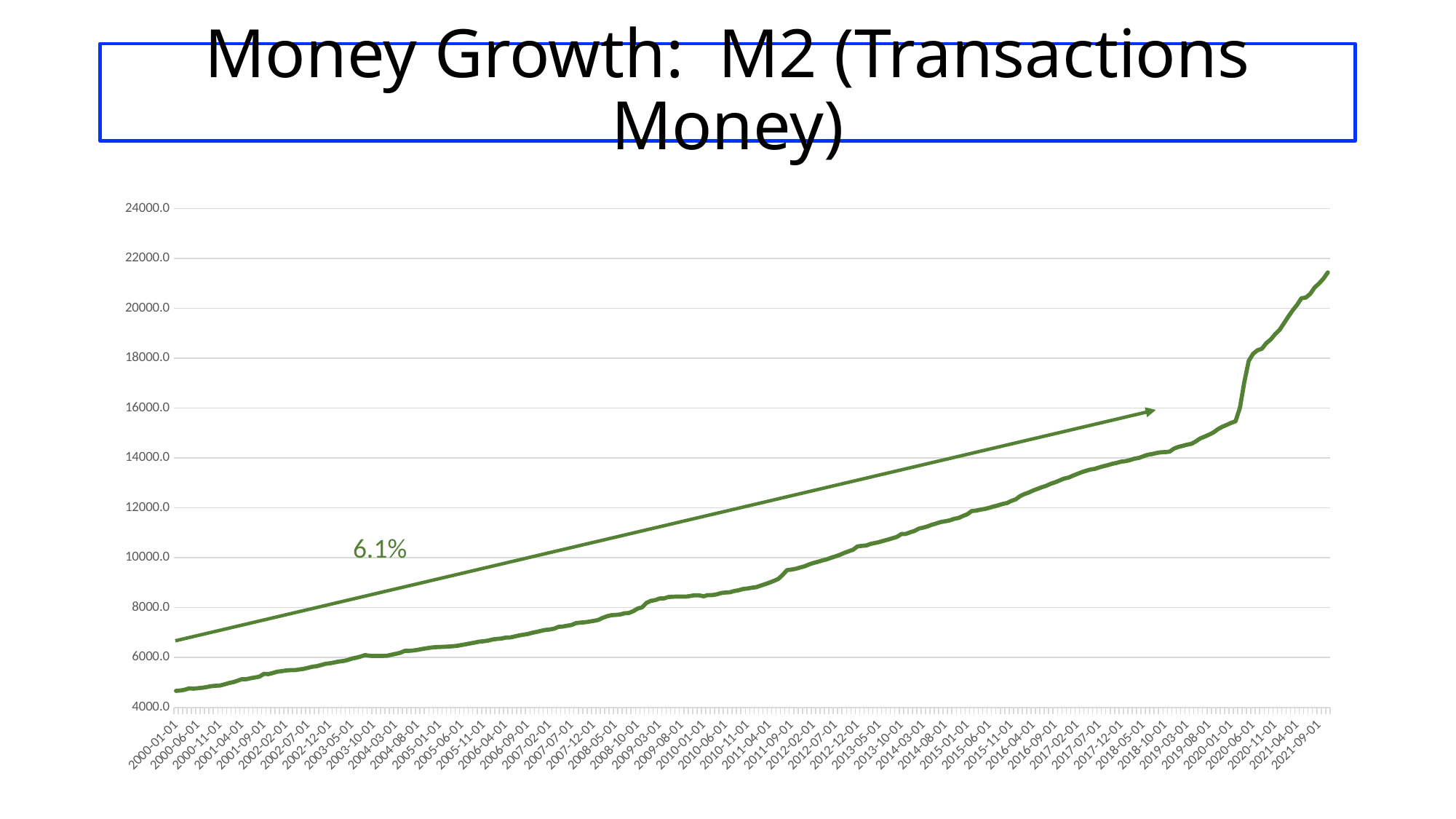
What percentage is written as an annotation next to the straight arrow on the chart? 6.1% Is the value at 2020-01-01 greater or less than 14000.0? greater What kind of chart is shown on the slide? line chart Which is larger, the value at 2010-01-01 or the value at 2018-05-01? 2018-05-01 Is the value at 2015-01-01 greater or less than 10000.0? greater Is the value at 2000-01-01 greater or less than 6000.0? less What is the highest value shown on the y axis? 24000.0 Which is larger, the value at 2021-09-01 or the value at 2000-01-01? 2021-09-01 Do the values generally rise or fall from 2000-01-01 to 2021-09-01? rise What is the title of the chart on the slide? Money Growth: M2 (Transactions Money)